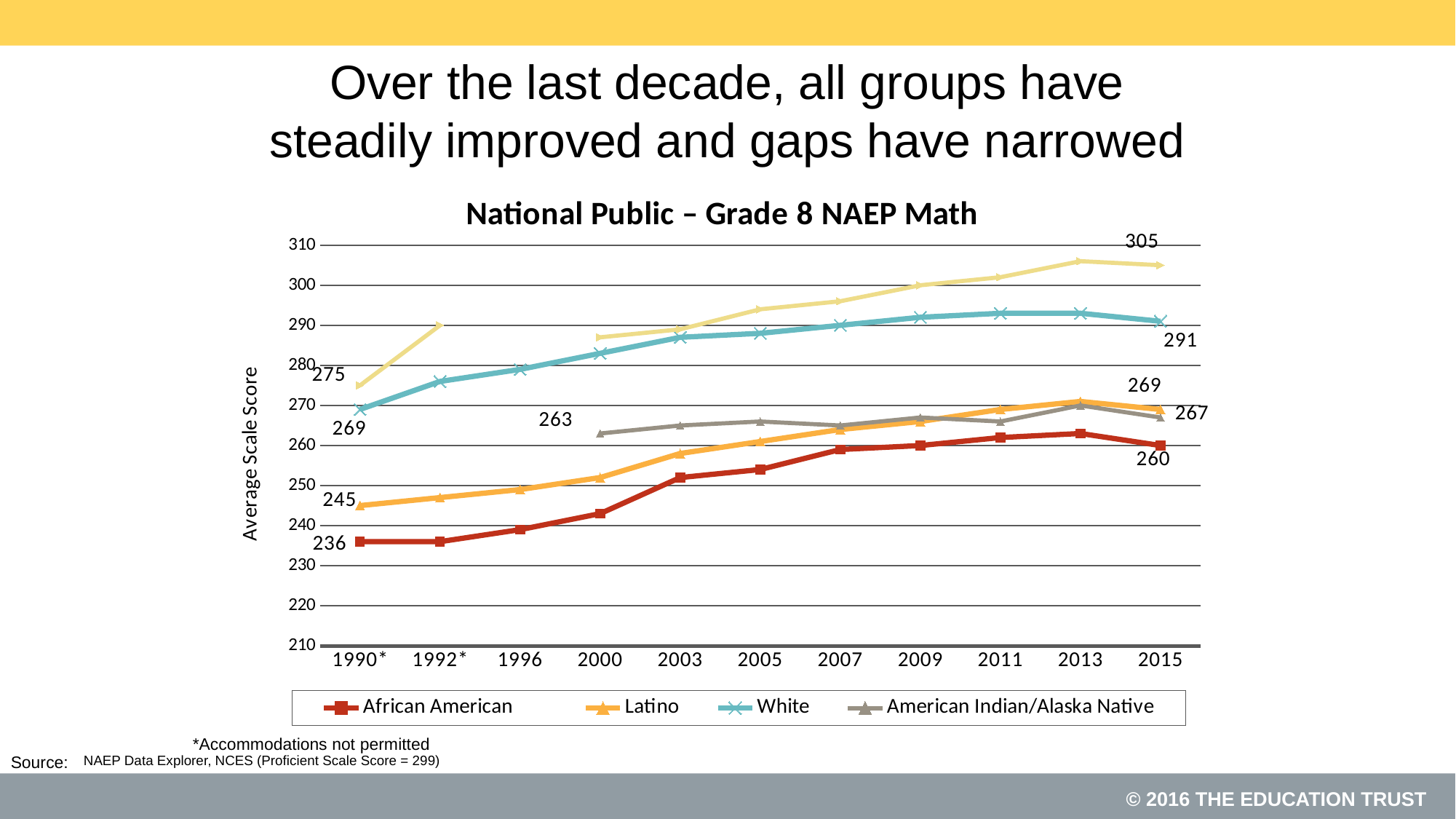
By how many points did the African American average scale score increase from 1990* to 2015? 24 What was the average scale score for White students in 2015? 291 How many series does the legend list? 4 What was the average scale score for African American students in 2015? 260 What was the average scale score for American Indian/Alaska Native students in 2000? 263 What kind of chart is shown on the slide? line chart How many years are shown on the x axis? 11 What was the average scale score for White students in 1990*? 269 What is the difference between the 2015 scores of White students and African American students? 31 What was the average scale score for Latino students in 1990*? 245 In 2015, which group had the higher score: Latino or American Indian/Alaska Native? Latino Is the value for African American students in 2000 greater or less than 250? less